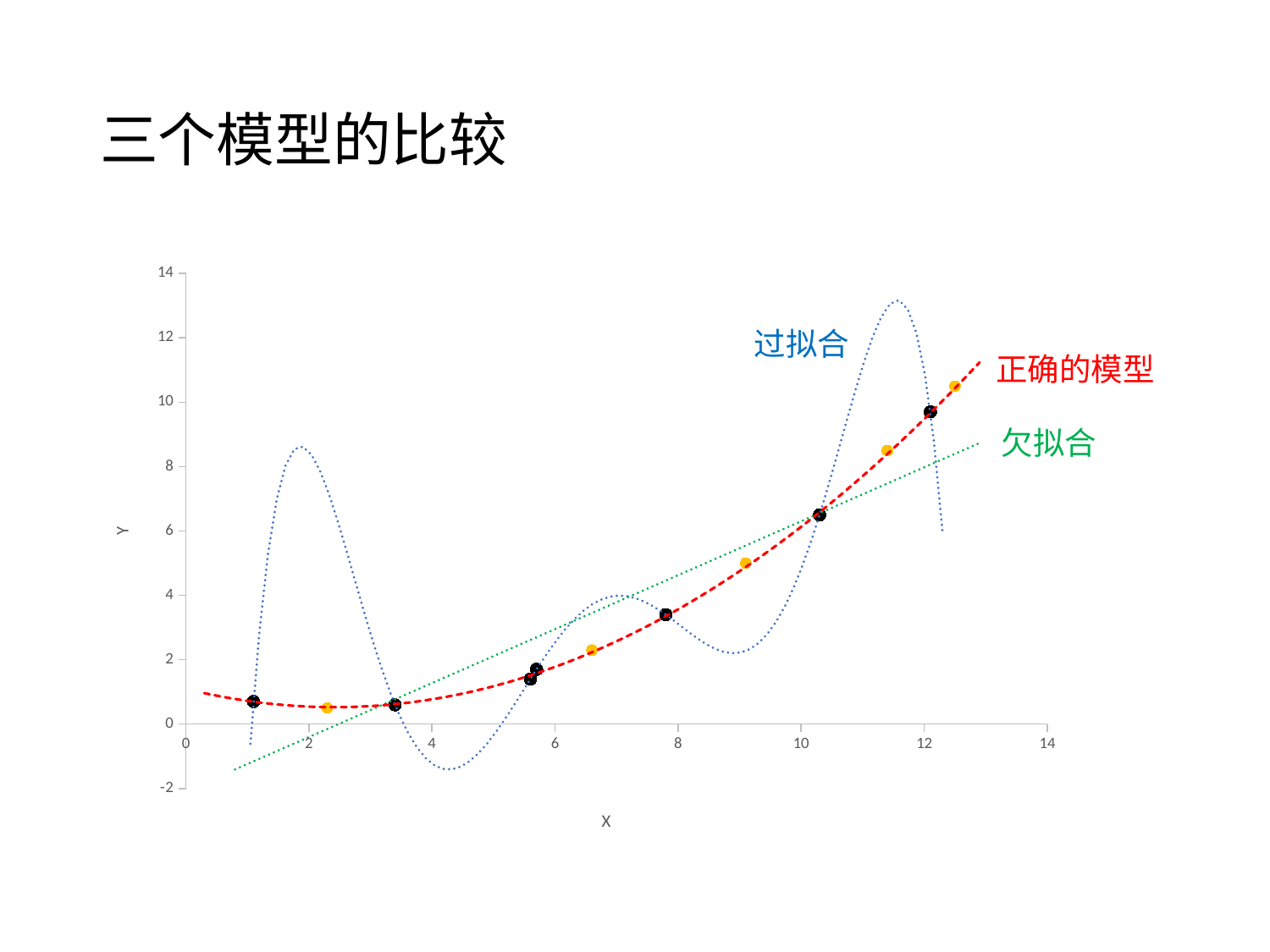
Is the Y value of the data point near X = 1 greater or less than 2? less Which has a higher Y value: the data point near X = 10 or the data point near X = 6? the data point near X = 10 What is the label of the green dotted line? 欠拟合 What label is written on the horizontal axis of the chart? X What is the maximum value shown on the Y axis? 14 Is the highest peak of the blue dotted curve (过拟合) greater or less than 12 on the Y axis? greater Does the red dashed curve (正确的模型) generally rise or fall as X increases from 4 to 12? rise Is the Y value of the data point near X = 12 greater or less than 8? greater What kind of chart is shown on the slide? scatter chart